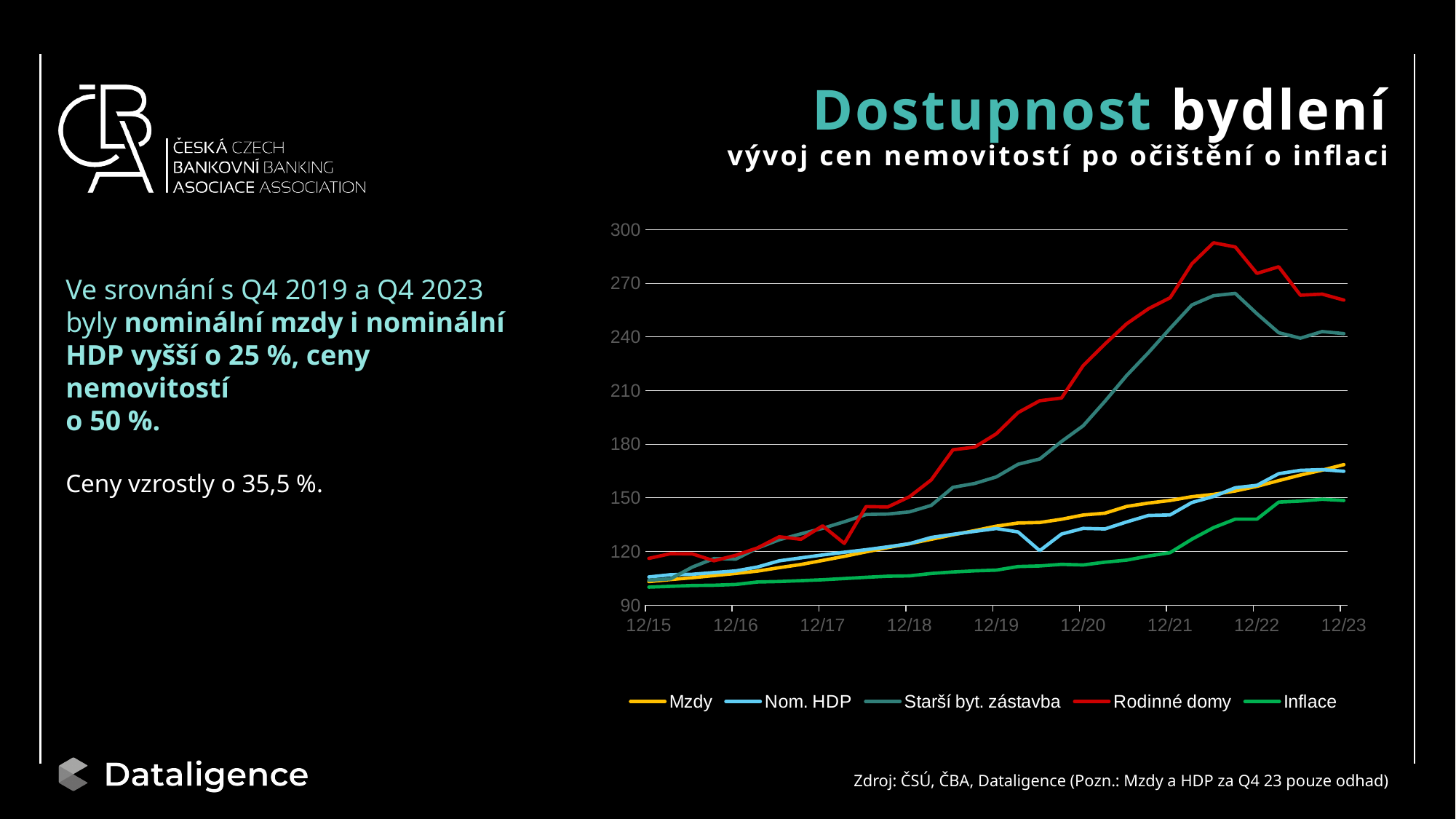
Which series has the highest value at 12/23? Rodinné domy Is the value for Starší byt. zástavba at 12/21 greater or less than 240? greater How many series does the legend list? 5 Which series has the lowest value at 12/23? Inflace Is the value for Mzdy at 12/23 greater or less than 150? greater What kind of chart is shown on the slide? line chart At 12/20, which is larger: Rodinné domy or Mzdy? Rodinné domy Is the value for Inflace at 12/19 greater or less than 120? less Do the values for Inflace rise or fall from 12/15 to 12/23? rise How many date labels are shown on the x axis? 9